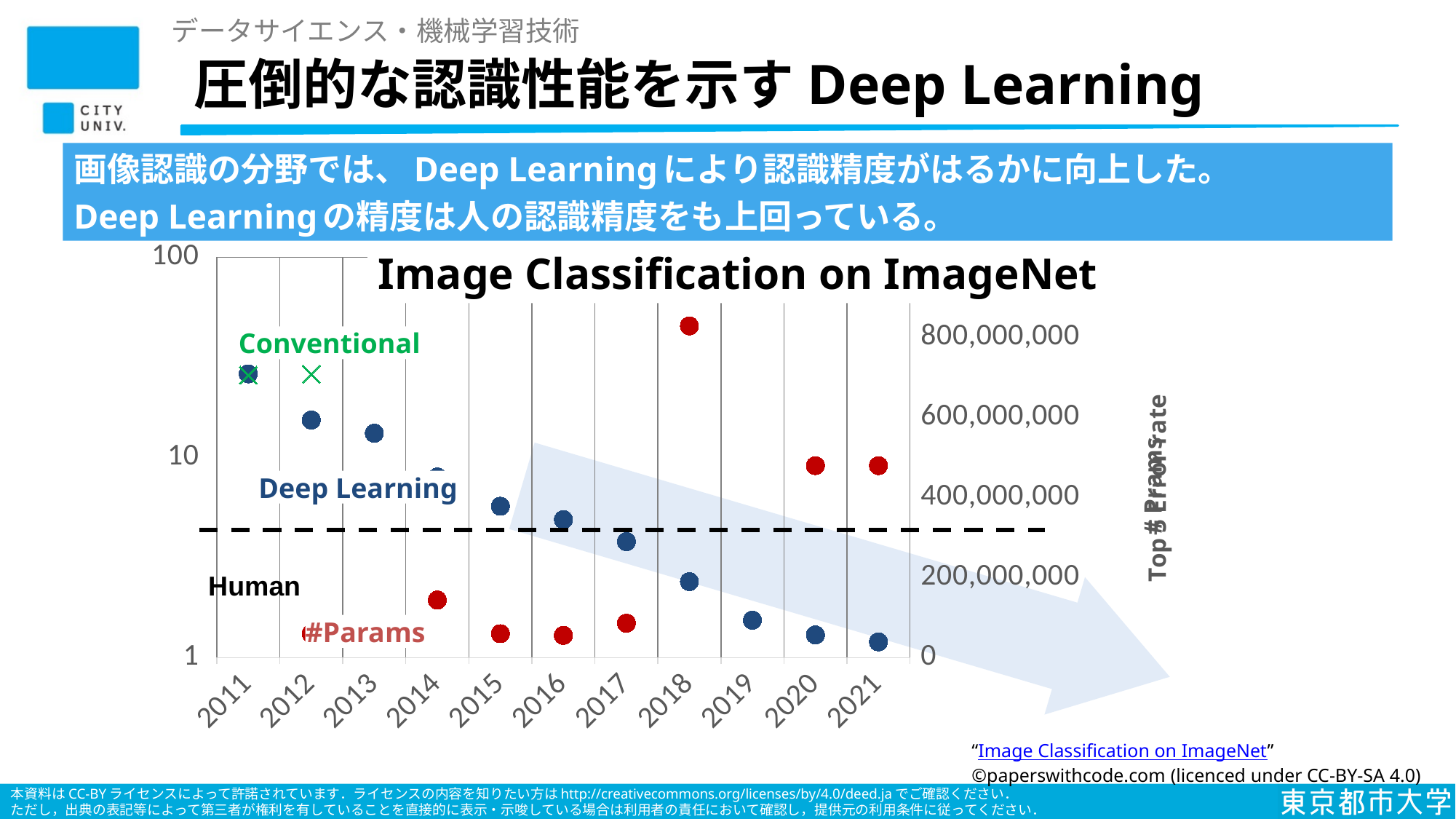
What is the title of the chart? Image Classification on ImageNet Is the Deep Learning value for 2021 greater or less than 10? less Is the Deep Learning value for 2011 greater or less than 10? greater Is the #Params value for 2018 greater or less than 600,000,000? greater How many green Conventional points are plotted on the chart? 2 How many years are labelled on the x axis of the chart? 11 Do the Deep Learning values rise or fall from 2011 to 2021? fall Which year has the highest Deep Learning error rate value? 2011 Which year has the highest #Params value? 2018 What kind of chart is shown on the slide? scatter chart How many red #Params points are plotted on the chart? 8